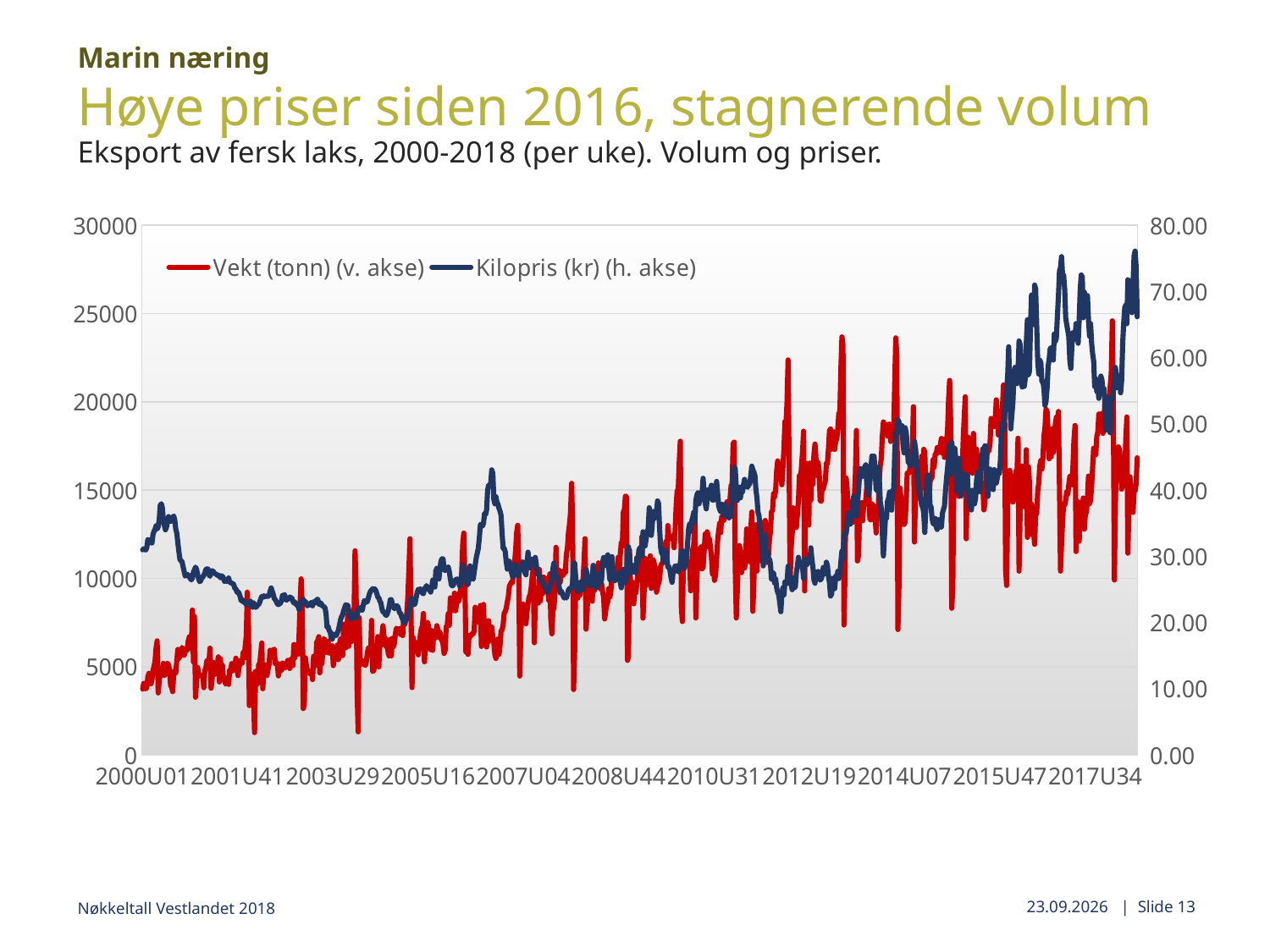
What kind of chart is shown on the slide? line chart How many series does the legend list? 2 Is the Kilopris (kr) value at 2000U01 greater or less than 20.00 on the right axis? greater Does the Vekt (tonn) series generally rise or fall across the period shown? rise Is the Vekt (tonn) value at 2000U01 greater or less than 10000 on the left axis? less What is the maximum value shown on the right-hand axis? 80.00 Does the Kilopris (kr) series generally rise or fall from 2000U01 to the end of the period? rise Is the Vekt (tonn) value around 2017U34 greater or less than 10000? greater How many labels are shown on the x axis? 11 Which series is plotted on the right-hand axis (h. akse)? Kilopris (kr)